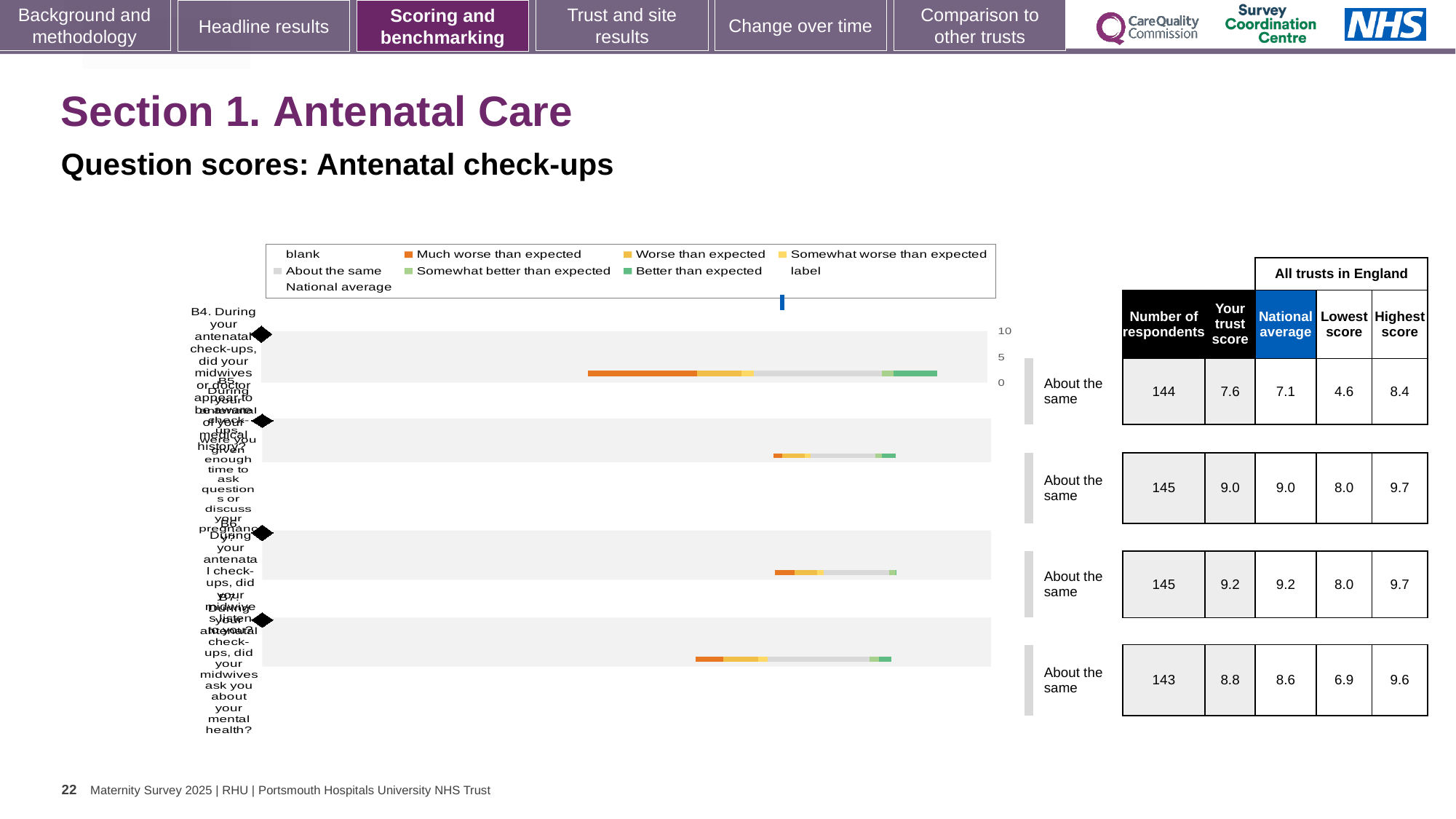
How many question rows (bars) does the chart show? 4 For the bottom row (question B7), which is larger: 'Your trust score' or the national average? Your trust score (8.8) Which row in the table has the lowest 'Your trust score'? the top row (7.6) What colour does the legend use for 'Much worse than expected'? orange What kind of chart is shown on the slide? bar chart In the table next to the chart, what is 'Your trust score' for the top row (question B4)? 7.6 What benchmark label is shown beside each of the four bars? About the same In the table next to the chart, what is the national average for the top row (question B4)? 7.1 In the table next to the chart, what is the number of respondents for the top row (question B4)? 144 For the top row (question B4), what is the difference between 'Your trust score' and the national average? 0.5 Which row in the table has the highest 'Your trust score'? the third row (9.2) In the table next to the chart, what is the highest score among all trusts in England for the bottom row (question B7)? 9.6